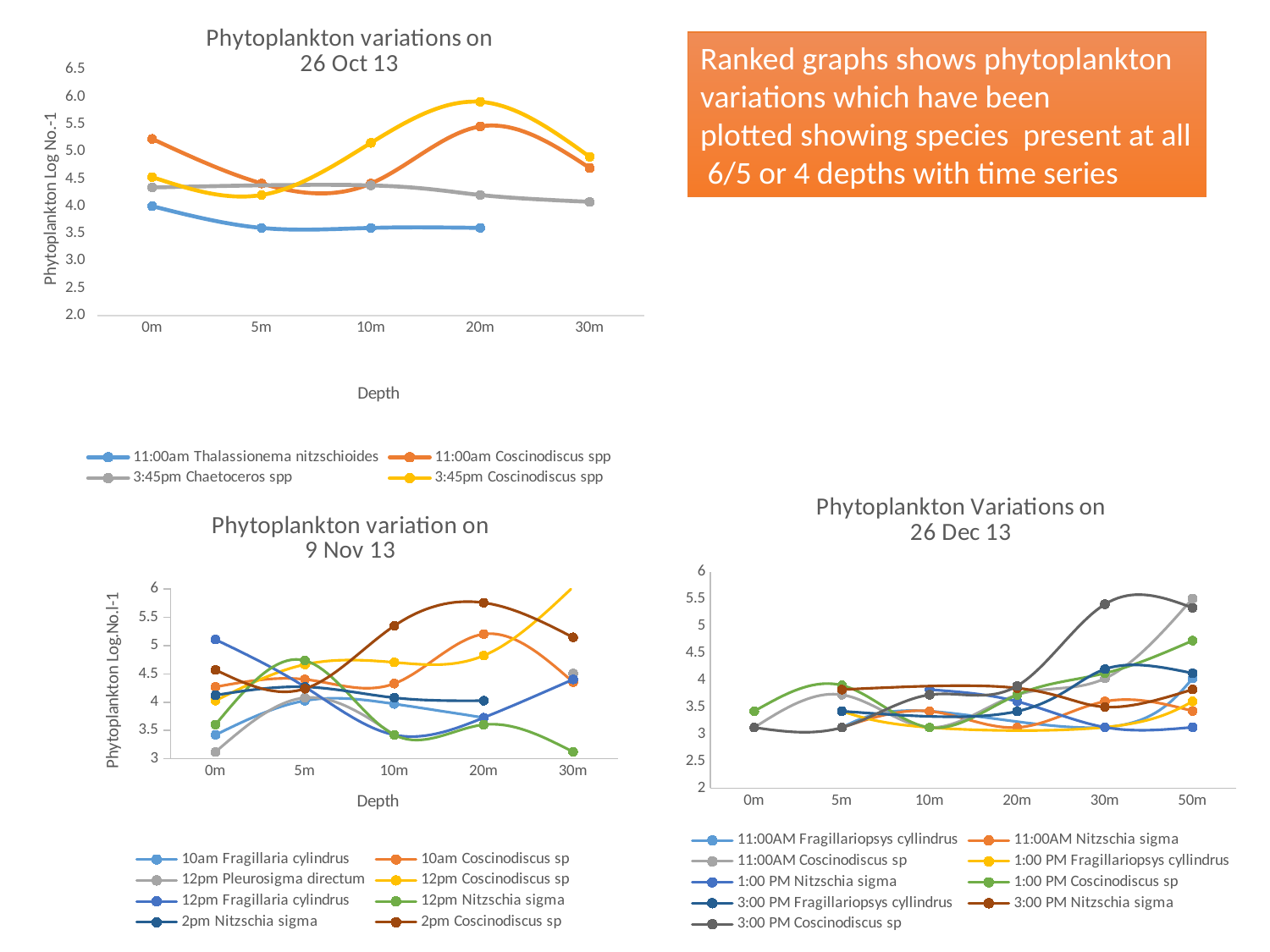
How many series does the legend of the 'Phytoplankton Variations on 26 Dec 13' chart list? 9 In the 'Phytoplankton variations on 26 Oct 13' chart, is the value for 11:00am Thalassionema nitzschioides at 0m greater or less than 4.5? less In the 'Phytoplankton variations on 26 Oct 13' chart, which is larger at 20m: 3:45pm Coscinodiscus spp or 3:45pm Chaetoceros spp? 3:45pm Coscinodiscus spp How many depth categories are shown on the x axis of the 'Phytoplankton variations on 26 Oct 13' chart? 5 What kind of chart is the 'Phytoplankton variations on 26 Oct 13' chart? Line chart How many depth categories are shown on the x axis of the 'Phytoplankton Variations on 26 Dec 13' chart? 6 In the 'Phytoplankton variations on 26 Oct 13' chart, does the 11:00am Thalassionema nitzschioides series rise or fall from 0m to 5m? Fall How many series does the legend of the 'Phytoplankton variations on 26 Oct 13' chart list? 4 In the 'Phytoplankton variations on 26 Oct 13' chart, is the value for 3:45pm Coscinodiscus spp at 20m greater or less than 5.5? greater How many series does the legend of the 'Phytoplankton variation on 9 Nov 13' chart list? 8 In the 'Phytoplankton variation on 9 Nov 13' chart, which series has the highest value at 30m? 12pm Coscinodiscus sp In the 'Phytoplankton variation on 9 Nov 13' chart, is the value for 2pm Coscinodiscus sp at 20m greater or less than 5.5? greater